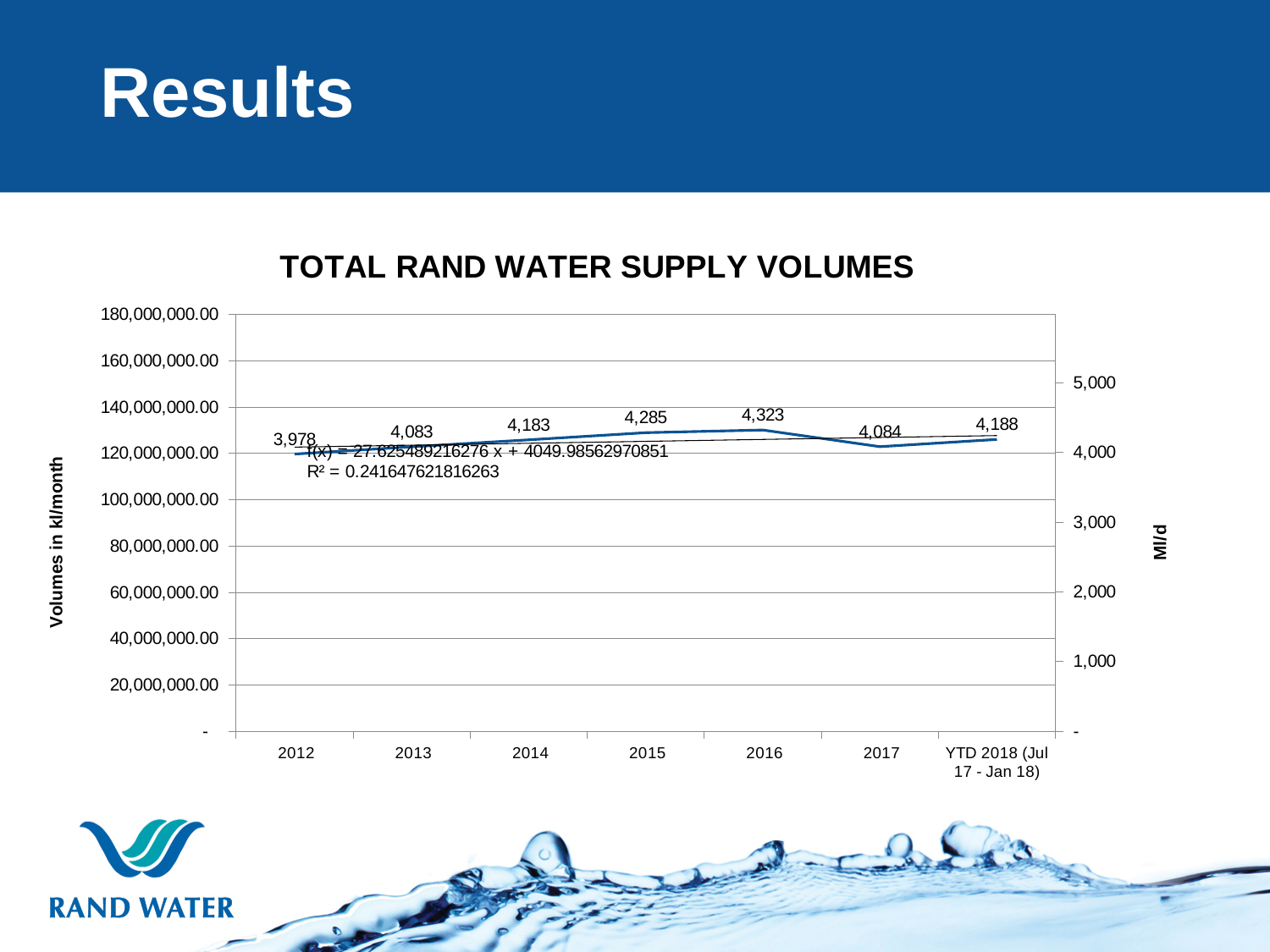
Which year has the lowest value? 2012 What is the difference between the values for 2013 and 2012? 105 What is the value for 2016? 4,323 Which is larger, the value for 2015 or the value for 2017? 2015 What is the value for 2012? 3,978 Which year has the highest value? 2016 What is the value for YTD 2018 (Jul 17 - Jan 18)? 4,188 What is the title of the chart? TOTAL RAND WATER SUPPLY VOLUMES Is the value for 2014 greater or less than 4,000 on the right axis? greater How many time periods are plotted on the x axis? 7 What kind of chart is this? line chart What is the difference between the values for 2016 and 2017? 239